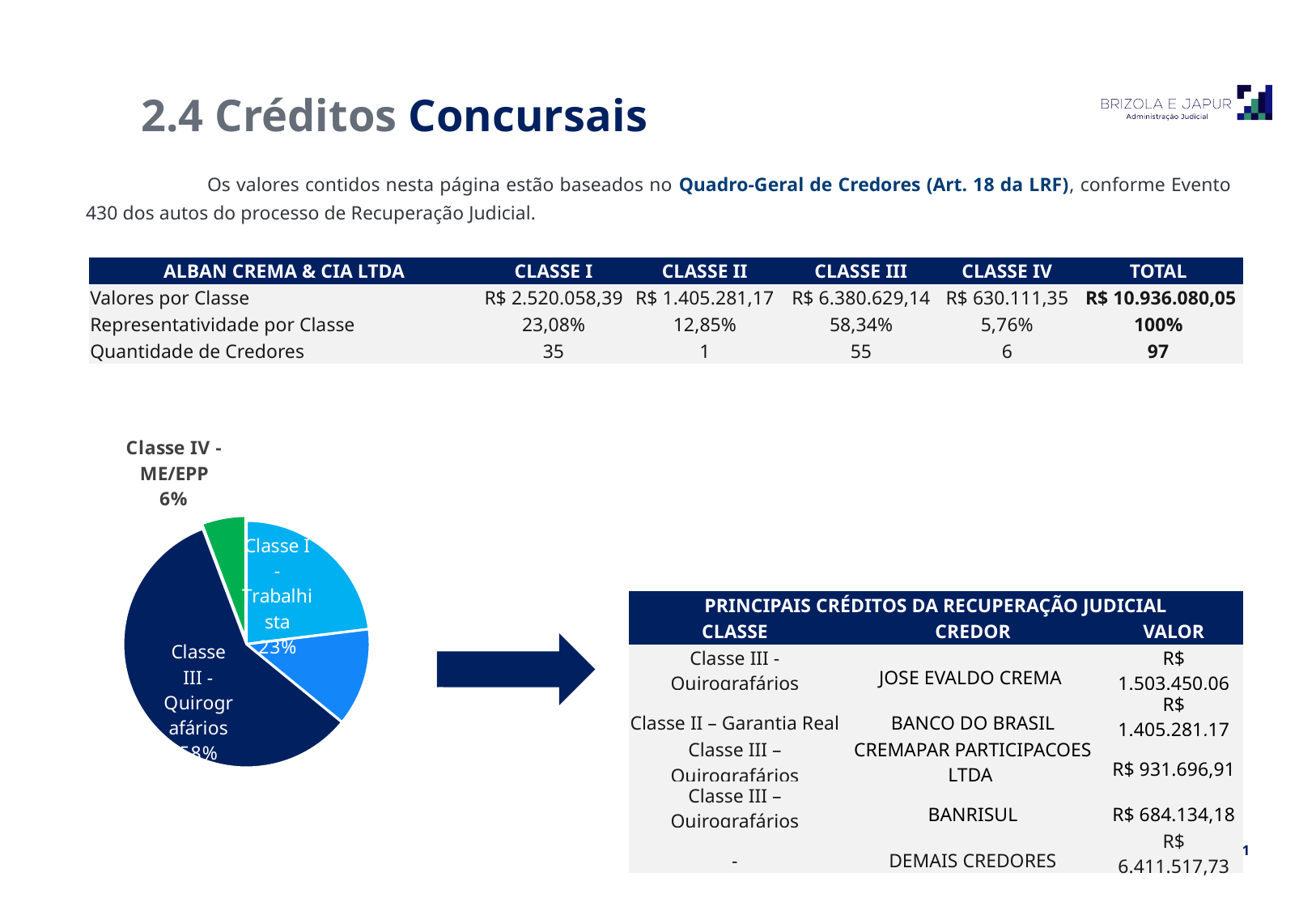
What share of the pie chart does Classe IV - ME/EPP represent? 6% What kind of chart is shown on the slide? pie chart What colour is the Classe IV - ME/EPP slice in the pie chart? green What colour is the Classe III - Quirografários slice in the pie chart? dark blue By how many percentage points does the Classe III - Quirografários share exceed the Classe I - Trabalhista share in the pie chart? 35 percentage points What share of the pie chart does Classe III - Quirografários represent? 58% By how many percentage points does the Classe I - Trabalhista share exceed the Classe IV - ME/EPP share in the pie chart? 17 percentage points Which slice is larger in the pie chart, Classe I - Trabalhista or Classe IV - ME/EPP? Classe I - Trabalhista Which slice of the pie chart is the largest? Classe III - Quirografários Which slice of the pie chart is the smallest? Classe IV - ME/EPP What share of the pie chart does Classe I - Trabalhista represent? 23% How many slices does the pie chart have? 4